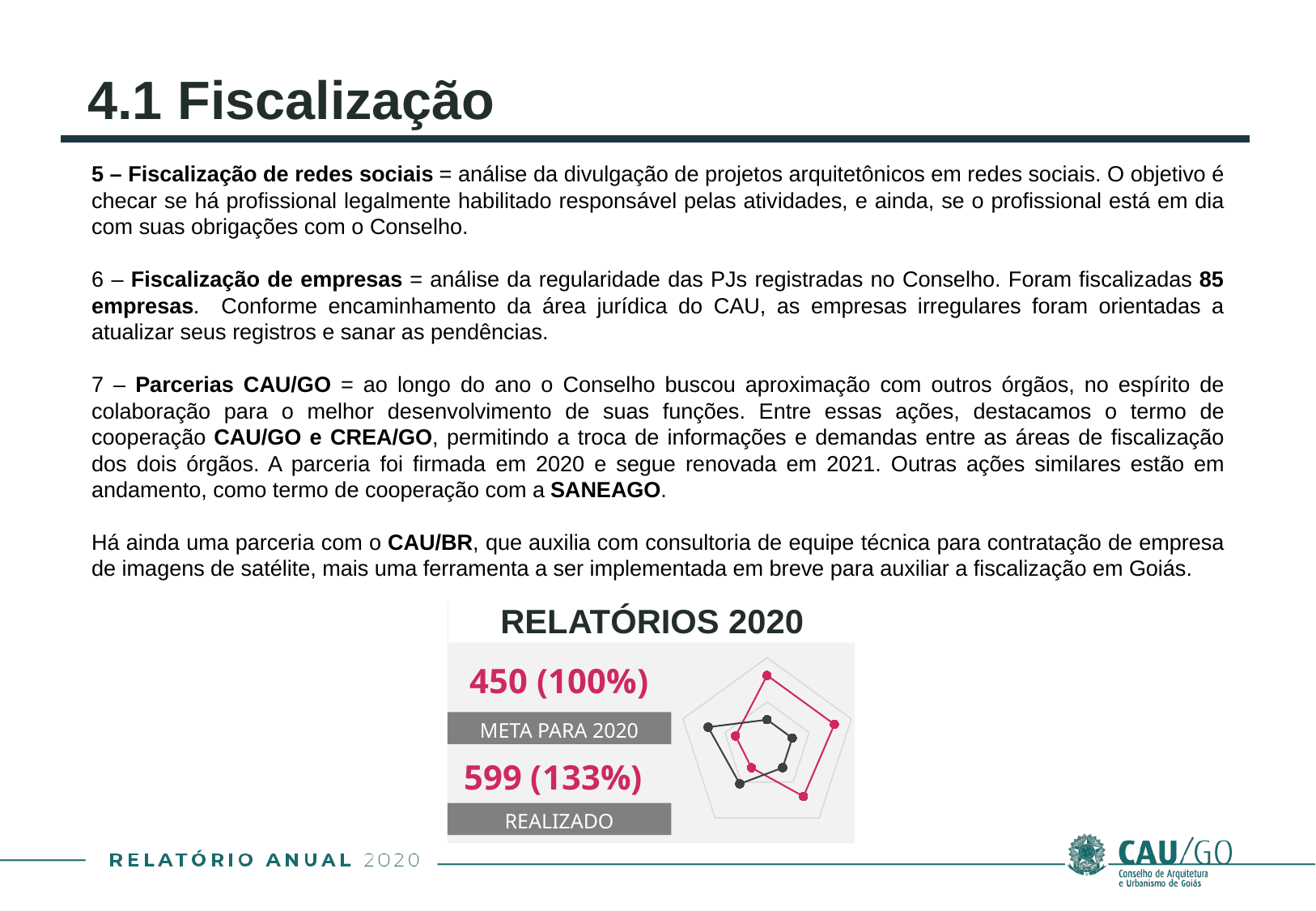
In the RELATÓRIOS 2020 chart, what percentage of the target does the REALIZADO value represent? 133% In the RELATÓRIOS 2020 chart, by how much does the REALIZADO value exceed the META PARA 2020 value? 149 In the RELATÓRIOS 2020 chart, what is the value shown for META PARA 2020? 450 (100%) How many data series are plotted on the radar chart in RELATÓRIOS 2020? 2 In the RELATÓRIOS 2020 chart, what is the value shown for REALIZADO? 599 (133%) How many axes (points) does the radar chart in RELATÓRIOS 2020 have? 5 In the RELATÓRIOS 2020 chart, which is larger, the META PARA 2020 value or the REALIZADO value? REALIZADO What kind of chart is shown under the RELATÓRIOS 2020 title? radar chart What is the title of the chart on the slide? RELATÓRIOS 2020 In the RELATÓRIOS 2020 chart, what colour is used for the REALIZADO value text? pink